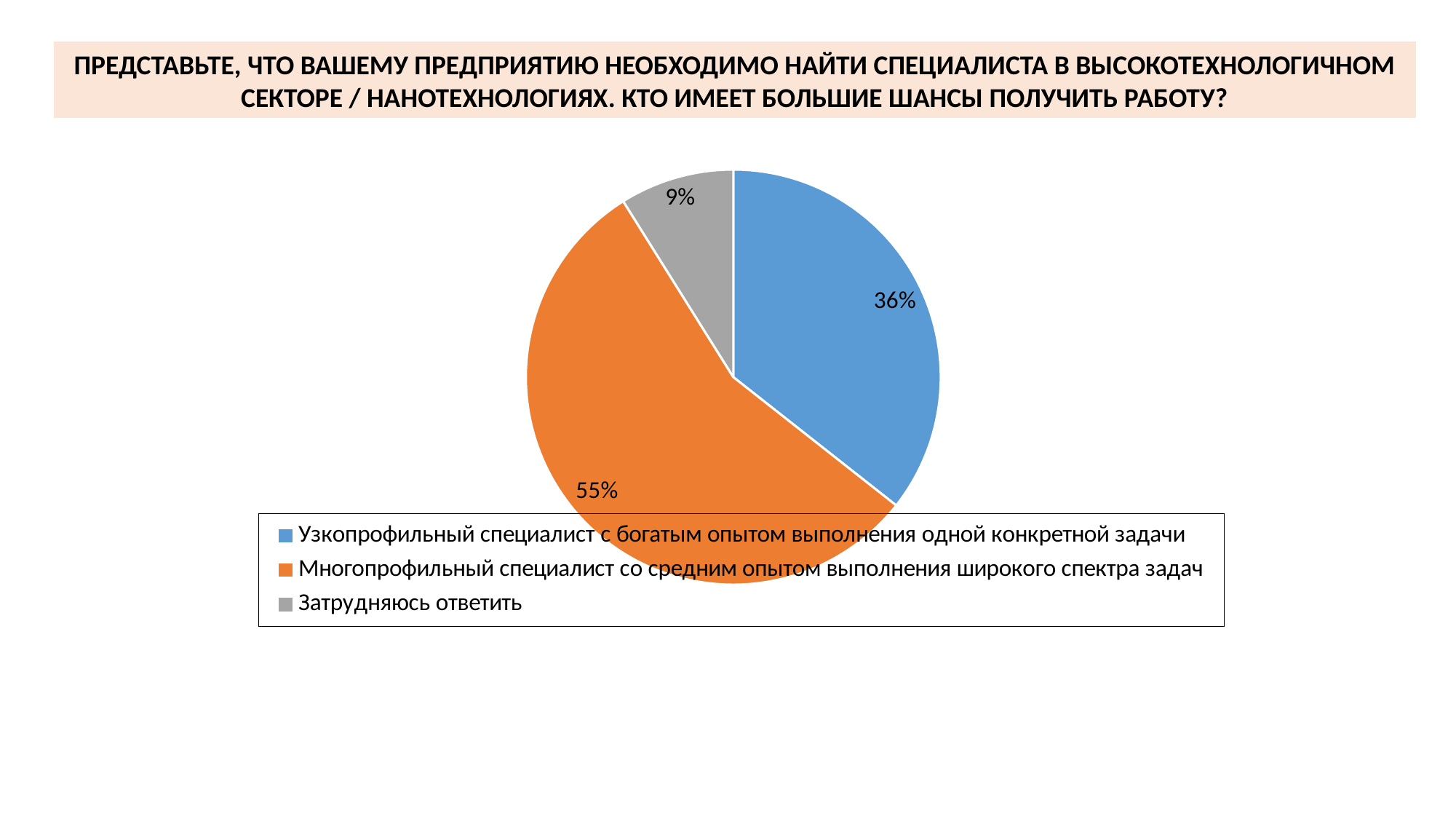
Which is larger: the share for 'Узкопрофильный специалист с богатым опытом выполнения одной конкретной задачи' or for 'Затрудняюсь ответить'? Узкопрофильный специалист с богатым опытом выполнения одной конкретной задачи What colour is the slice for 'Затрудняюсь ответить'? Grey What share of the pie is for 'Затрудняюсь ответить'? 9% What share of the pie is for 'Многопрофильный специалист со средним опытом выполнения широкого спектра задач'? 55% What share of the pie is for 'Узкопрофильный специалист с богатым опытом выполнения одной конкретной задачи'? 36% What kind of chart is shown on the slide? Pie chart What colour is the slice for 'Многопрофильный специалист со средним опытом выполнения широкого спектра задач'? Orange How many categories does the pie chart show? 3 Which category has the smallest slice of the pie? Затрудняюсь ответить Which category has the largest slice of the pie? Многопрофильный специалист со средним опытом выполнения широкого спектра задач What is the difference in percentage points between the 'Многопрофильный специалист' slice and the 'Узкопрофильный специалист' slice? 19 What is the combined share of the two specialist categories (excluding 'Затрудняюсь ответить')? 91%